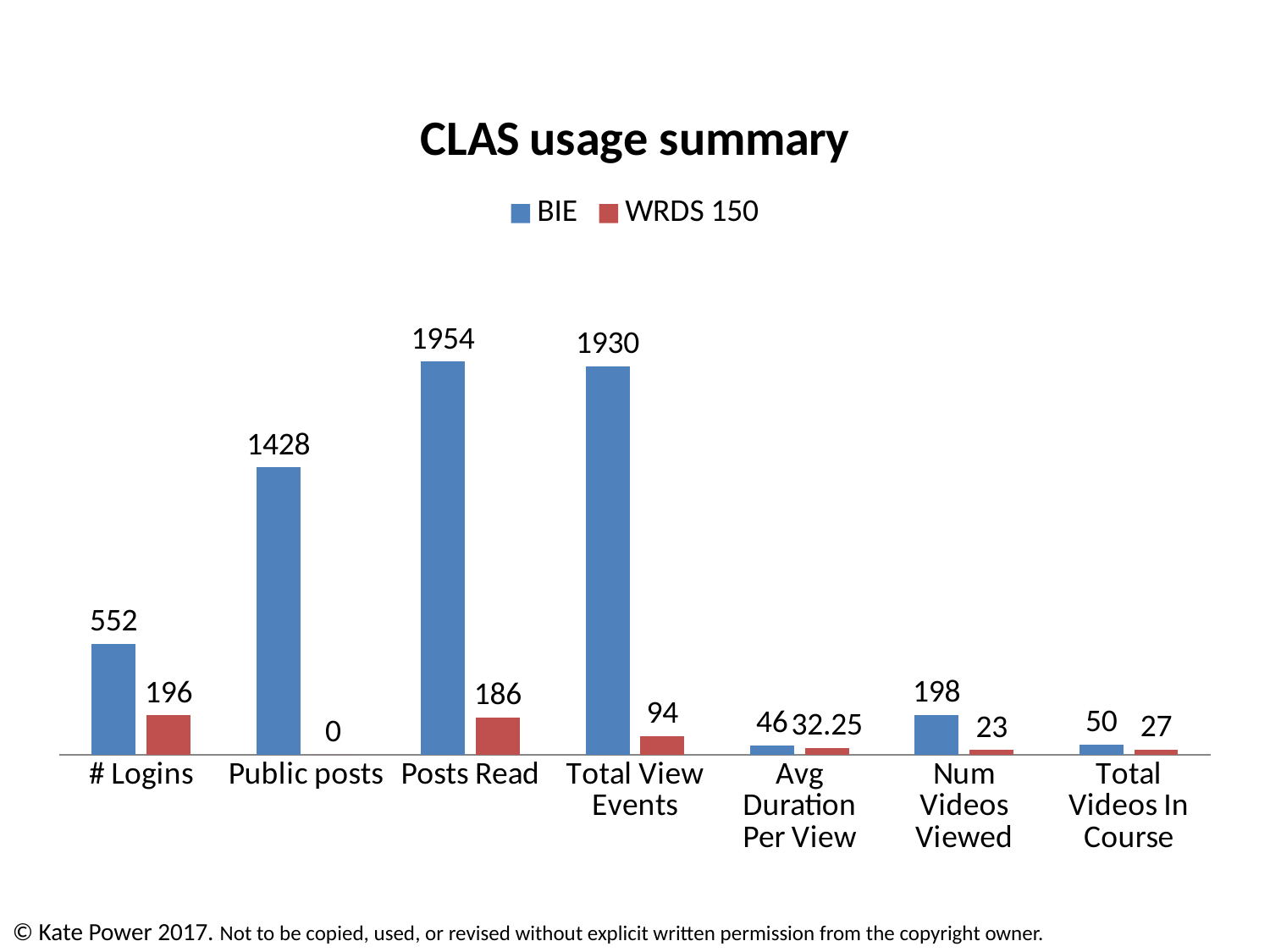
How many series does the legend list? 2 What is the value for BIE in the # Logins category? 552 What kind of chart is shown on the slide? Bar chart What is the value for WRDS 150 in the Posts Read category? 186 How many categories are shown on the x axis? 7 What is the value for WRDS 150 in the Avg Duration Per View category? 32.25 What is the title of the chart? CLAS usage summary Which category has the highest BIE value? Posts Read Which is larger, the BIE value for Public posts or the BIE value for # Logins? Public posts Which colour represents the WRDS 150 series? Red Which category has the lowest WRDS 150 value? Public posts What is the difference between the BIE and WRDS 150 values for Total View Events? 1836